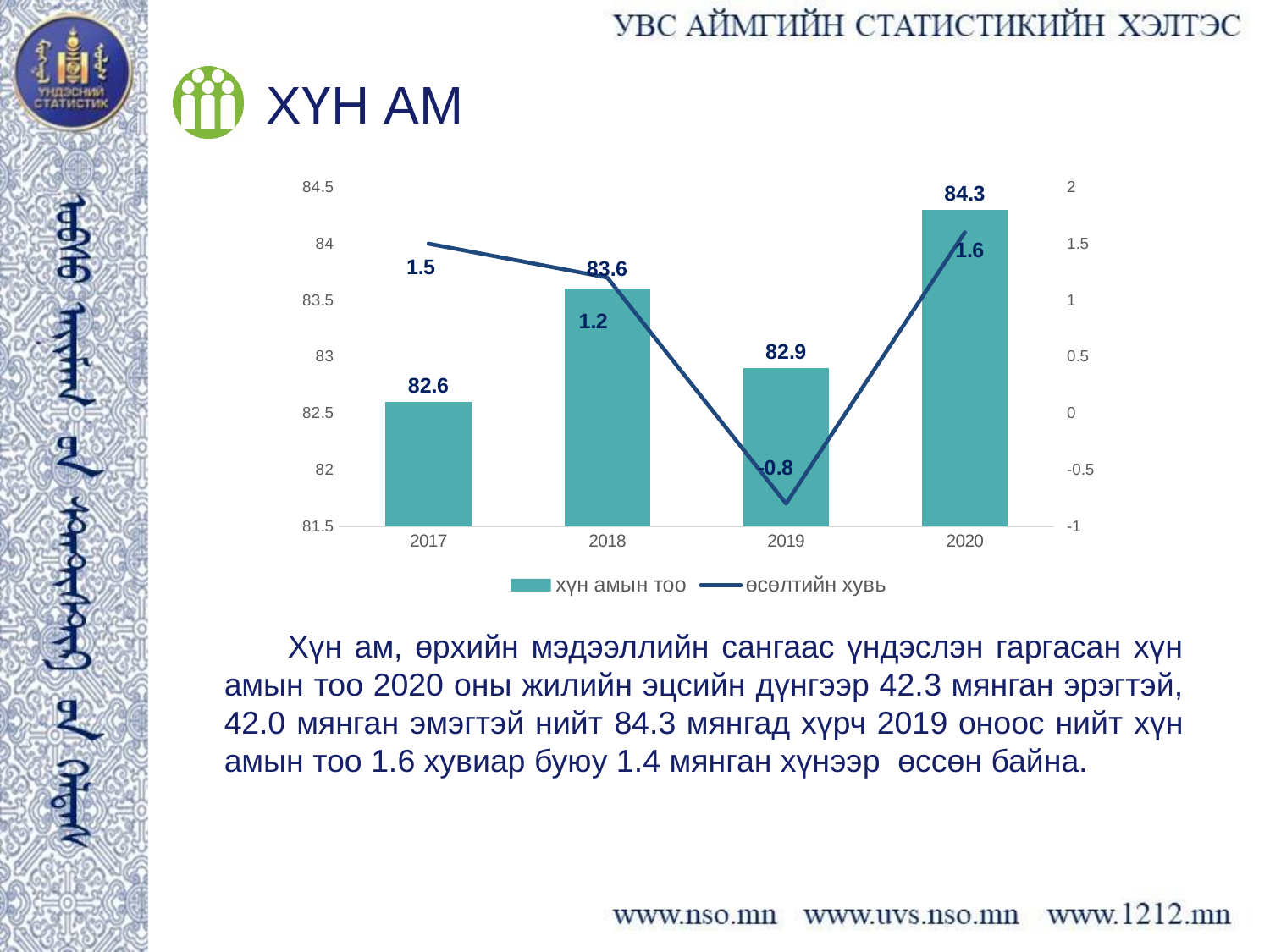
What is the value of хүн амын тоо for 2020? 84.3 Which is larger, the хүн амын тоо value for 2018 or for 2019? 2018 What is the value of өсөлтийн хувь for 2019? -0.8 Which year has the highest value of хүн амын тоо? 2020 Did the хүн амын тоо value rise or fall from 2018 to 2019? fall What is the value of хүн амын тоо for 2017? 82.6 What is the difference between the хүн амын тоо values for 2020 and 2019? 1.4 How many years are shown on the x axis of the chart? 4 Which year has the lowest value of өсөлтийн хувь? 2019 How many series does the chart legend list? 2 What are the two series named in the chart legend? хүн амын тоо and өсөлтийн хувь What is the value of өсөлтийн хувь for 2018? 1.2